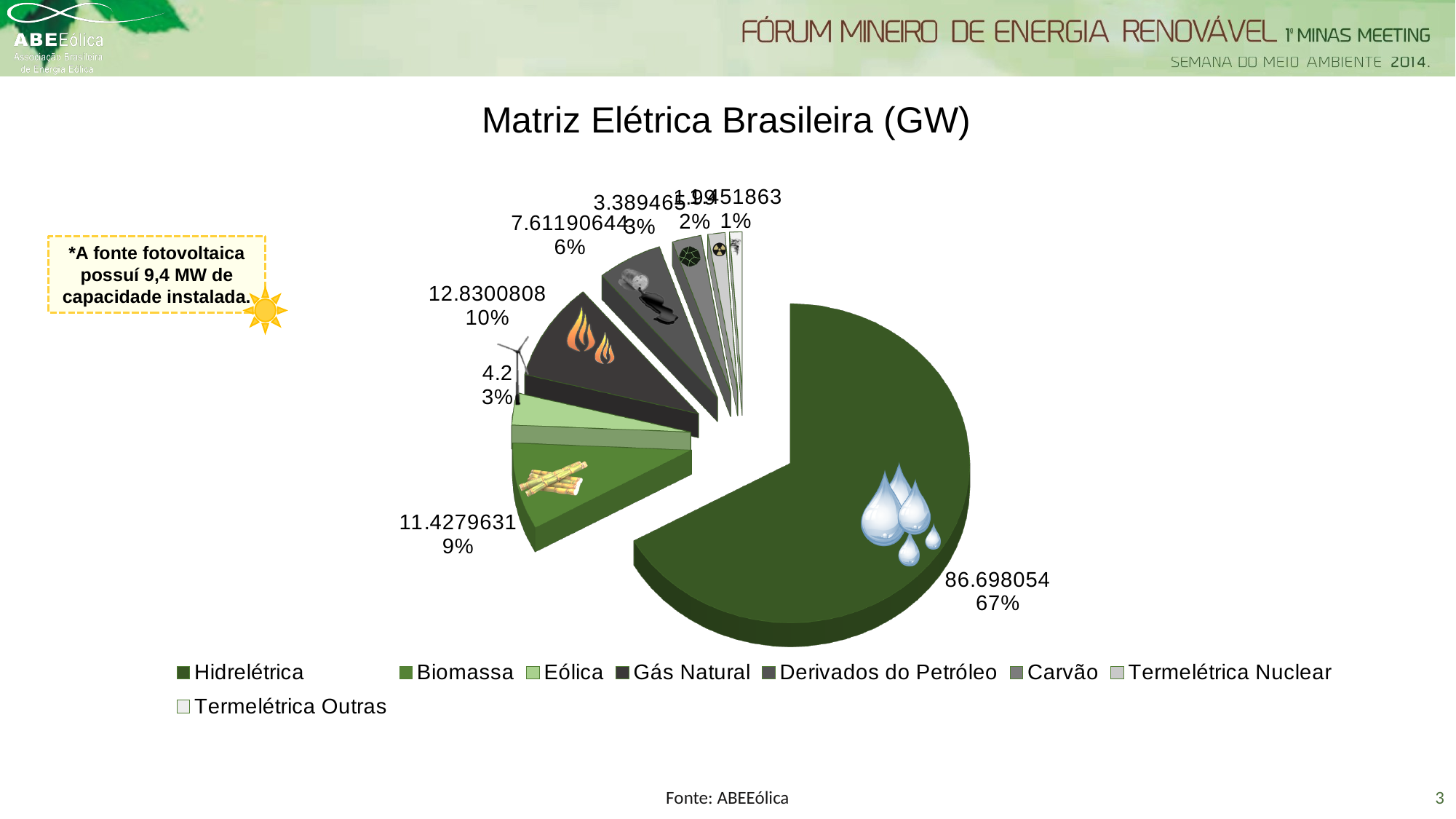
What share of the pie does Gás Natural represent? 10% What value is shown for Hidrelétrica? 86.698054 How many slices does the pie chart have? 8 Which category has the smallest slice of the pie? Termelétrica Outras Which category has the largest slice of the pie? Hidrelétrica How many entries does the chart legend list? 8 Which is larger, the value for Biomassa or the value for Gás Natural? Gás Natural What is the title of the chart? Matriz Elétrica Brasileira (GW) What share of the pie does Hidrelétrica represent? 67% What kind of chart is shown on the slide? pie chart What is the difference between the value for Gás Natural and the value for Biomassa? 1.4021177 What value is shown for Eólica? 4.2